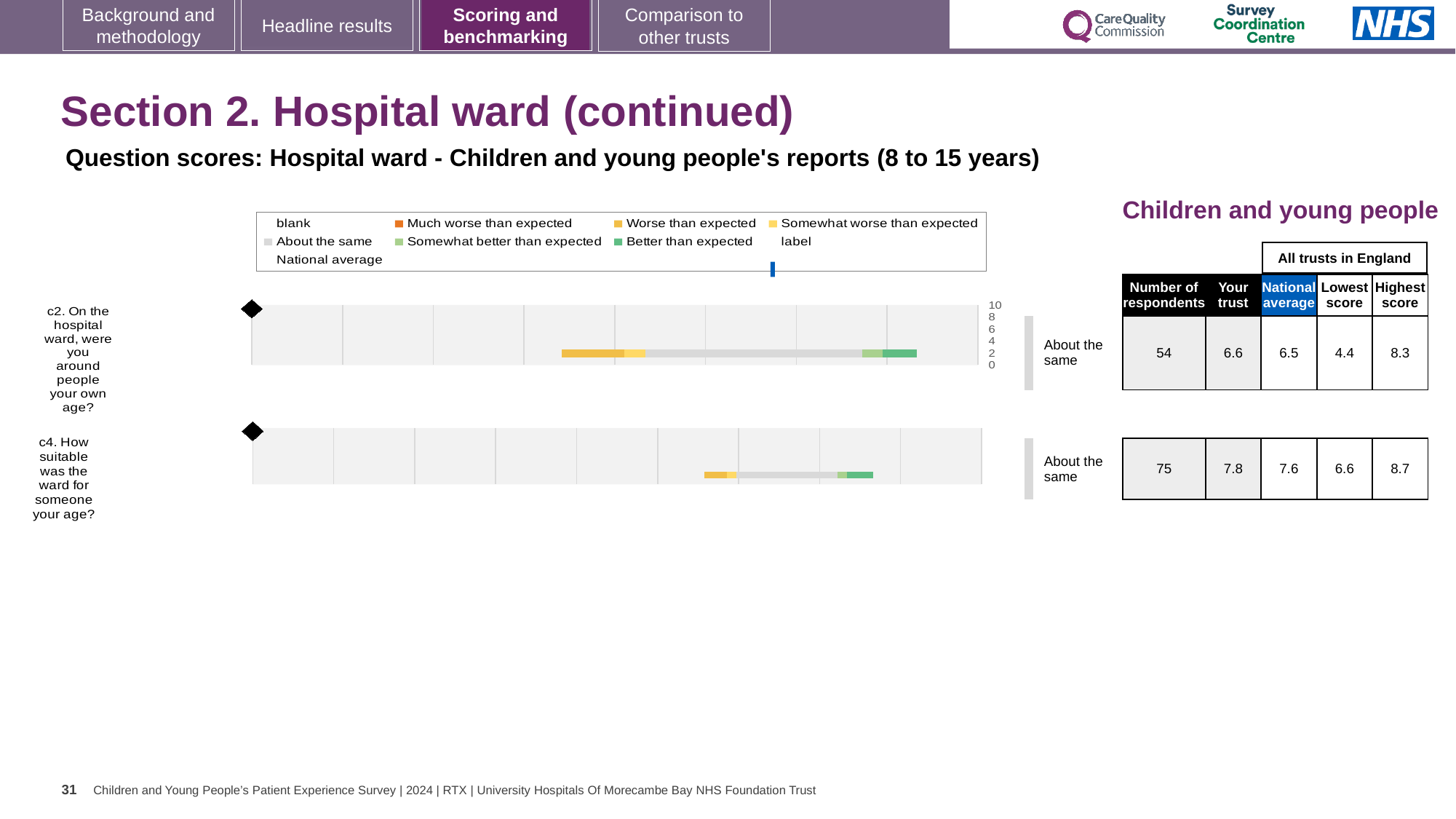
What is the 'Your trust' score for c2 (On the hospital ward, were you around people your own age?)? 6.6 What is the lowest score among all trusts in England for c2? 4.4 What benchmark category is shown for c4? About the same What kind of chart is used to show the question scores for c2 and c4? Bar chart What is the national average score for c4 (How suitable was the ward for someone your age?)? 7.6 By how much does the trust's score for c2 exceed the national average? 0.1 How many questions are plotted on the slide? 2 How many respondents answered question c2? 54 Which question has the higher 'Your trust' score, c2 or c4? c4 What colour represents 'Better than expected' in the legend? Green What is the highest score among all trusts in England for c4? 8.7 What is the difference between the highest and lowest scores for c4? 2.1